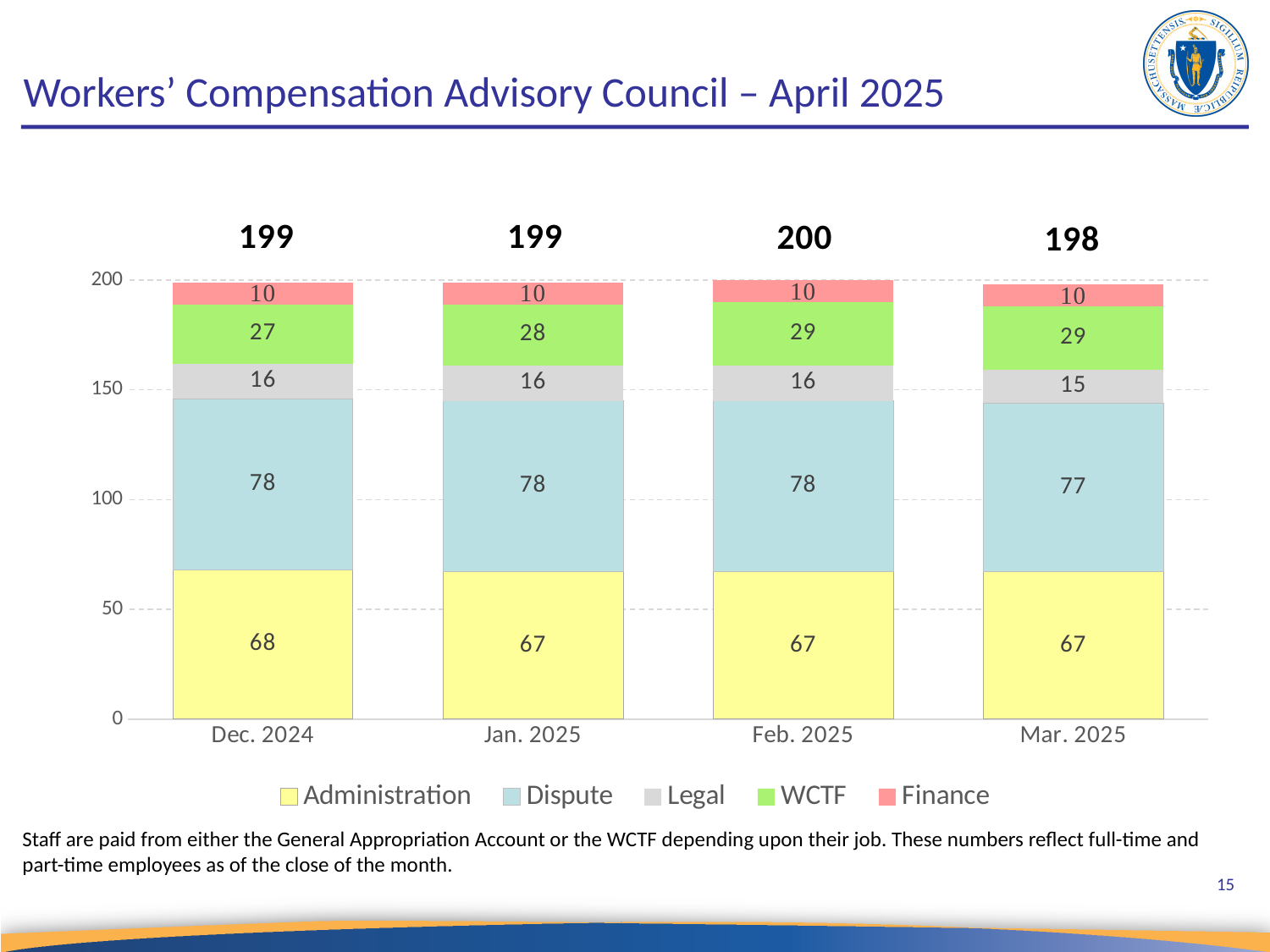
How many months are shown on the x axis? 4 What is the Legal value for Mar. 2025? 15 What is the Dispute value for Feb. 2025? 78 What is the difference between the WCTF values for Dec. 2024 and Feb. 2025? 2 What is the Administration value for Dec. 2024? 68 How many series does the legend list? 5 Which month has the lowest total staff count? Mar. 2025 What is the WCTF value for Jan. 2025? 28 What is the total of the stacked bar for Feb. 2025? 200 What is the total of the stacked bar for Mar. 2025? 198 Which is larger, the Dispute value for Jan. 2025 or the Dispute value for Mar. 2025? Jan. 2025 What kind of chart is shown on the slide? Stacked bar chart